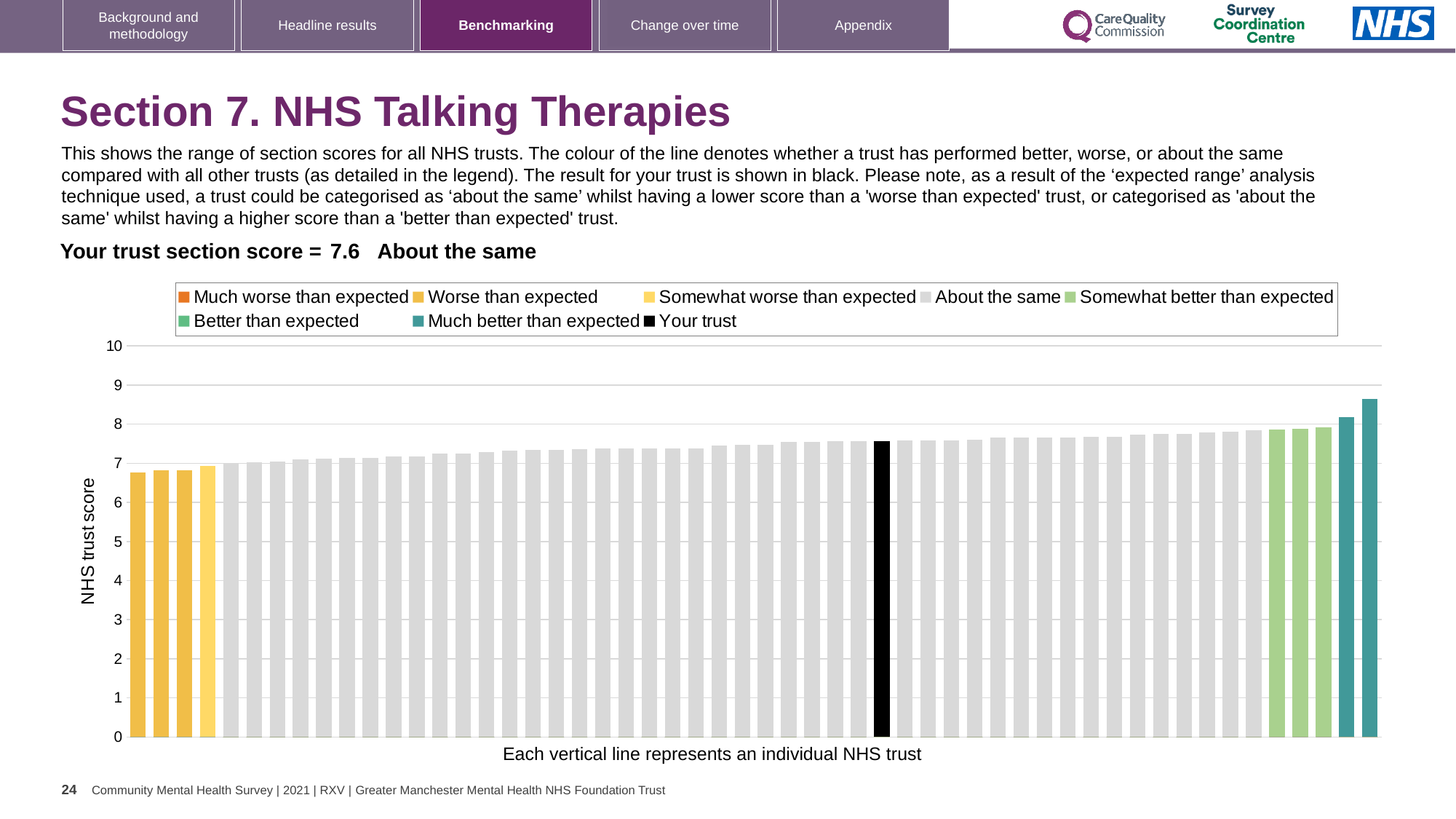
Is the value for your trust greater or less than 7? greater What is the label on the y axis? NHS trust score Which benchmarking category is your trust placed in? About the same How many entries does the chart legend list? 8 What kind of chart is shown on the slide? bar chart Is the value of the shortest bar greater or less than 7? less How many bars are shown in the 'Much better than expected' colour? 2 What is the section score for your trust? 7.6 Is the value of the tallest bar greater or less than 8? greater Do the bar values rise or fall from left to right along the x axis? rise What colour is the bar representing your trust? black